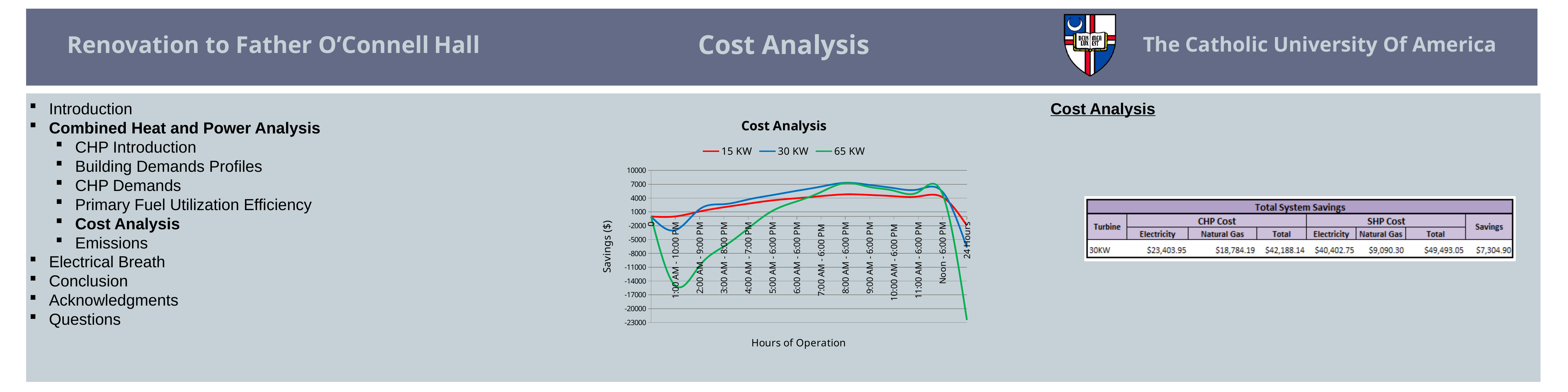
In the Cost Analysis chart, which series has the lowest value at 24 Hours? 65 KW What is the title of the y axis of the Cost Analysis chart? Savings ($) In the Cost Analysis chart, is the value for 15 KW at 8:00 AM - 6:00 PM greater or less than 1000? greater In the Cost Analysis chart, is the value for 65 KW at 1:00 AM - 10:00 PM greater or less than -11000? less What kind of chart is the Cost Analysis chart? line chart In the Cost Analysis chart, at 1:00 AM - 10:00 PM, which is larger: the 15 KW value or the 65 KW value? 15 KW In the Cost Analysis chart, is the value for 65 KW at 24 Hours greater or less than -20000? less In the Cost Analysis chart, does the 65 KW series rise or fall from 1:00 AM - 10:00 PM to 8:00 AM - 6:00 PM? rise How many categories are shown along the x axis of the Cost Analysis chart? 14 What is the title of the x axis of the Cost Analysis chart? Hours of Operation How many series does the legend of the Cost Analysis chart list? 3